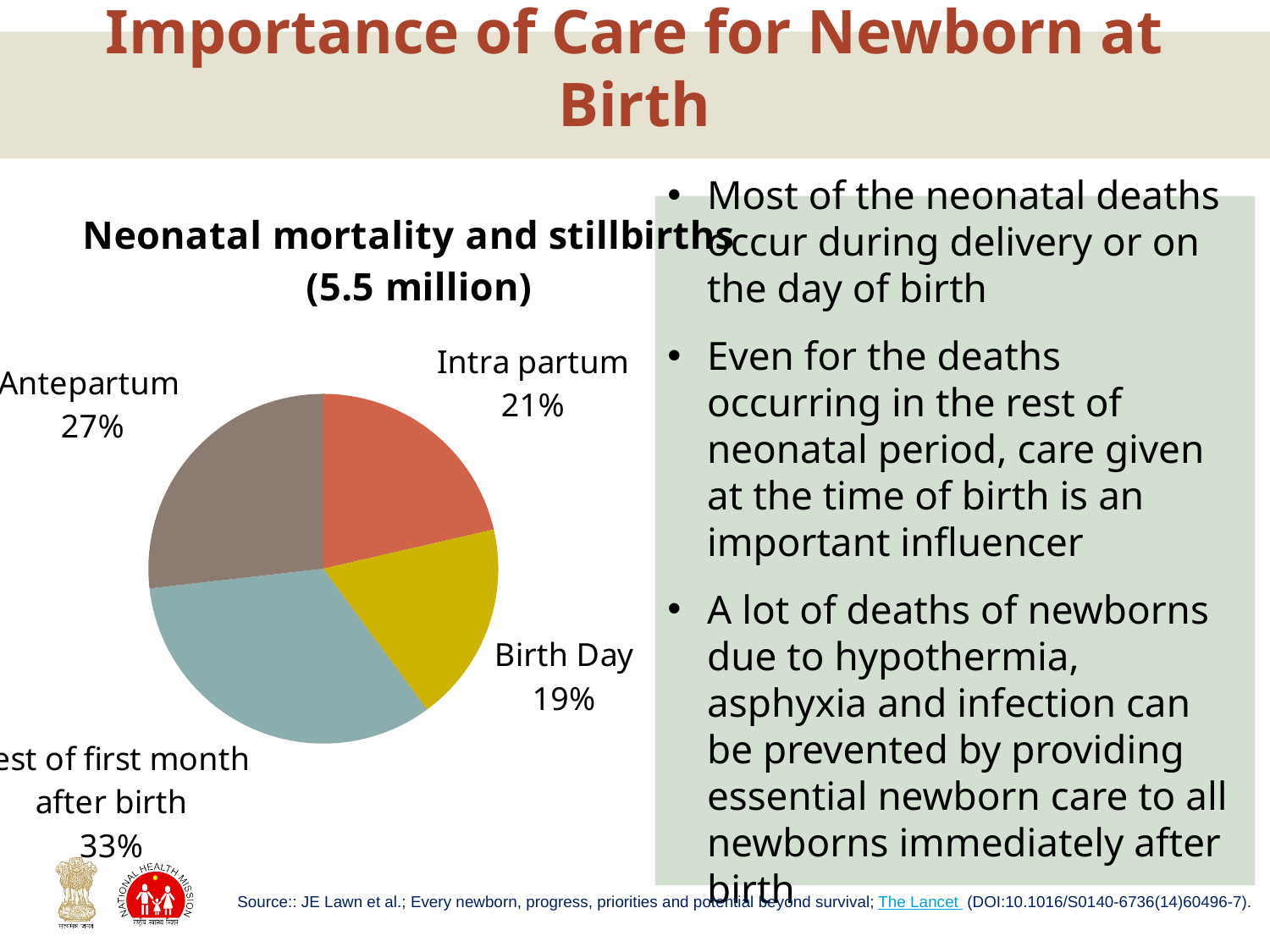
How many slices does the pie chart have? 4 Which slice of the pie chart is the smallest? Birth Day What share of the pie is Birth Day? 19% What is the title of the chart? Neonatal mortality and stillbirths (5.5 million) What share of the pie is Rest of first month after birth? 33% Which slice of the pie chart is the largest? Rest of first month after birth What share of the pie is Antepartum? 27% What is the combined share of Intra partum and Birth Day? 40% Which is larger, the Antepartum share or the Birth Day share? Antepartum What is the difference between the Antepartum and Intra partum shares? 6% What type of chart is shown on the slide? pie chart